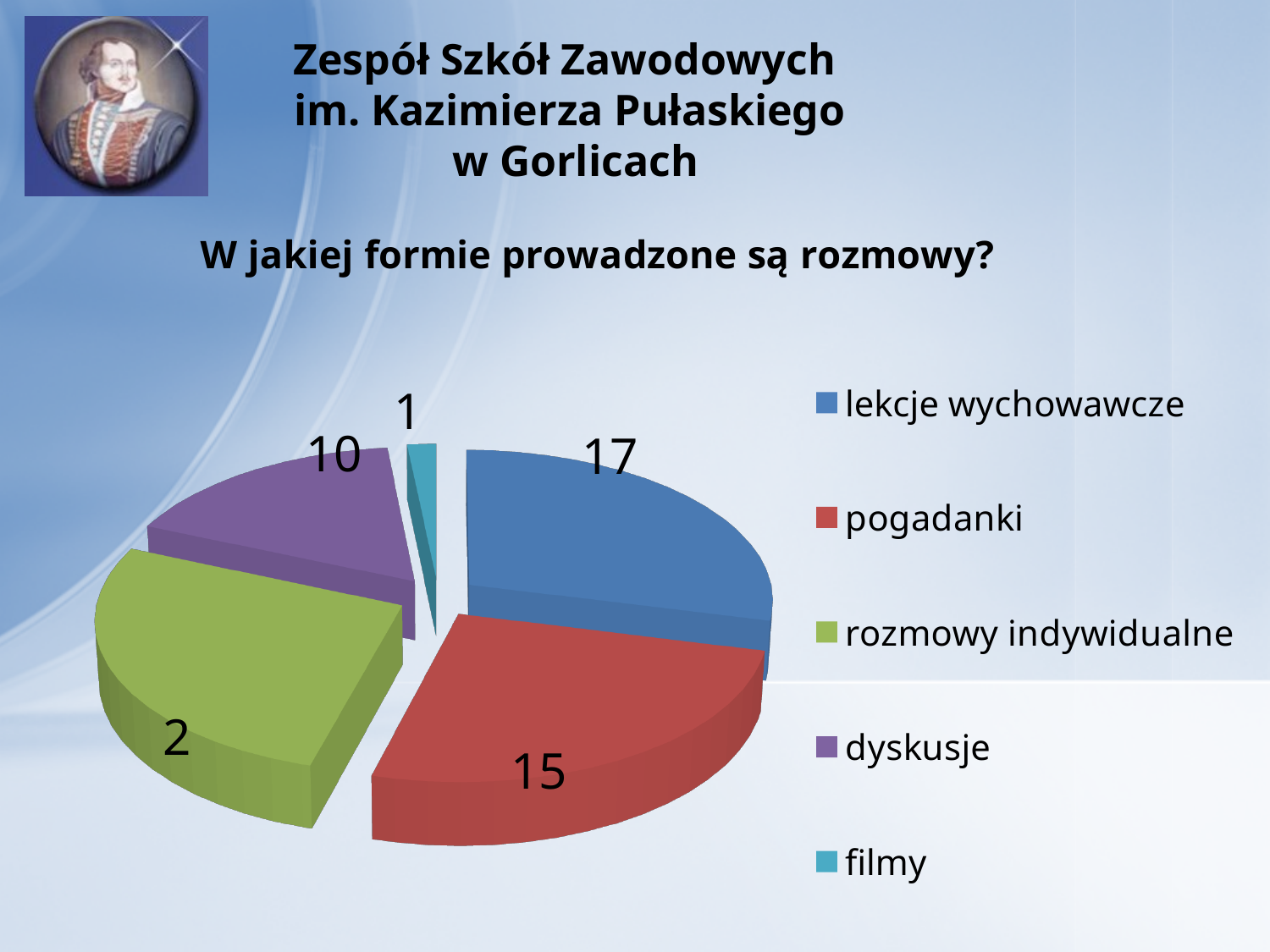
What value is shown for pogadanki? 15 What is the difference between the values for pogadanki and dyskusje? 5 What value is shown for dyskusje? 10 Which category has the lowest value? filmy What value is shown for lekcje wychowawcze? 17 What kind of chart is shown on the slide? pie chart Which is larger, the value for dyskusje or the value for filmy? dyskusje Which category has the highest value? lekcje wychowawcze How many categories does the legend list? 5 What value is shown for filmy? 1 What colour represents pogadanki in the chart? red What is the difference between the values for lekcje wychowawcze and pogadanki? 2